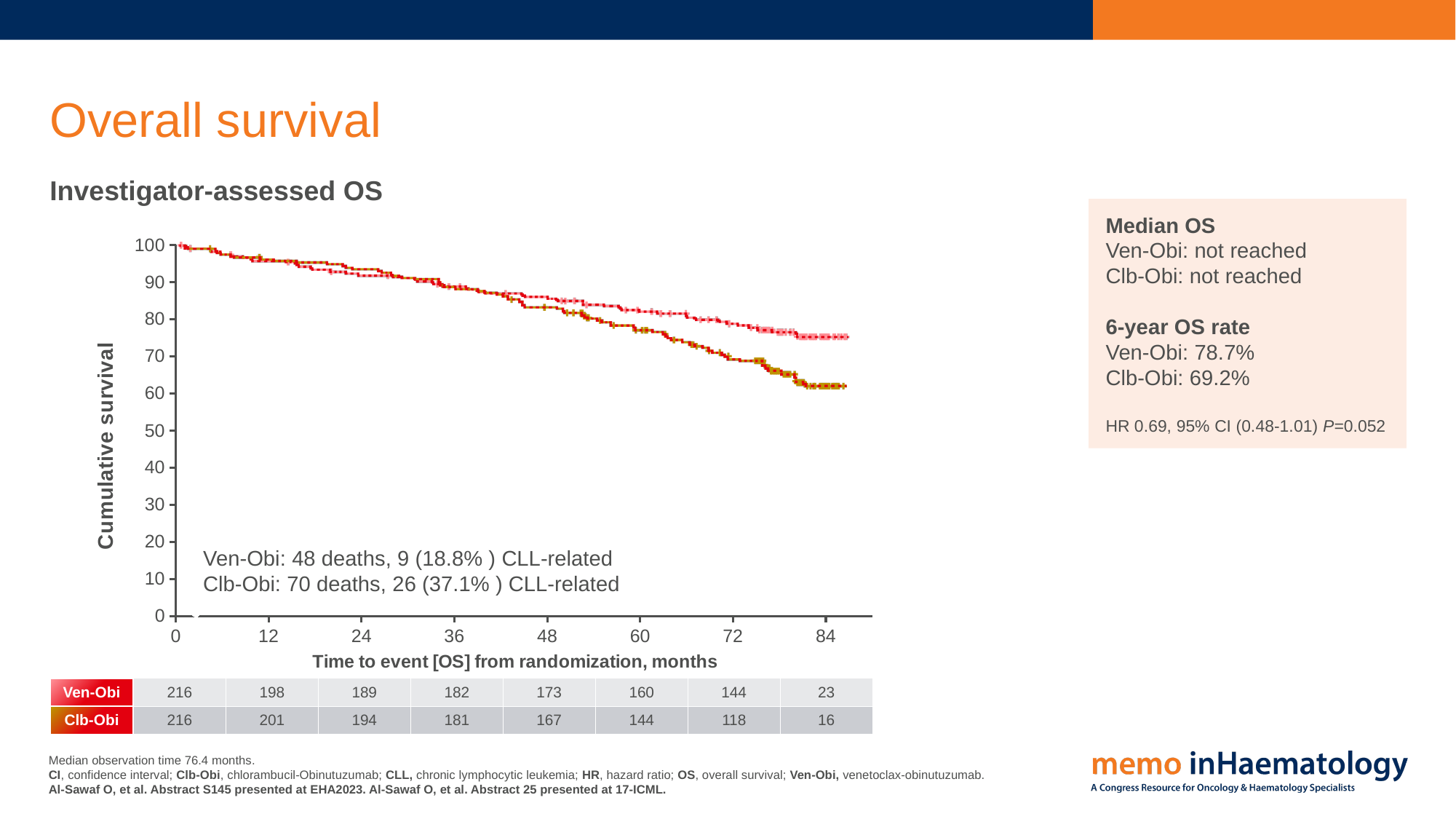
Do the cumulative survival curves rise or fall as time from randomization increases? Fall How many time points are listed on the x axis of the chart? 8 At 72 months, which curve shows higher cumulative survival, Ven-Obi or Clb-Obi? Ven-Obi According to the number-at-risk table, how many Clb-Obi patients were at risk at 60 months? 144 What is the 6-year OS rate for Clb-Obi? 69.2% What kind of chart is shown on the slide? Line chart (Kaplan-Meier survival curve) Is the cumulative survival for Ven-Obi at 84 months greater or less than 70? greater How many series (treatment arms) are plotted on the chart? 2 What is the difference in the number of patients at risk at 72 months between Ven-Obi and Clb-Obi? 26 According to the number-at-risk table, how many Ven-Obi patients were at risk at 48 months? 173 What is the label of the x axis of the chart? Time to event [OS] from randomization, months Is the cumulative survival for Clb-Obi at 84 months greater or less than 70? less